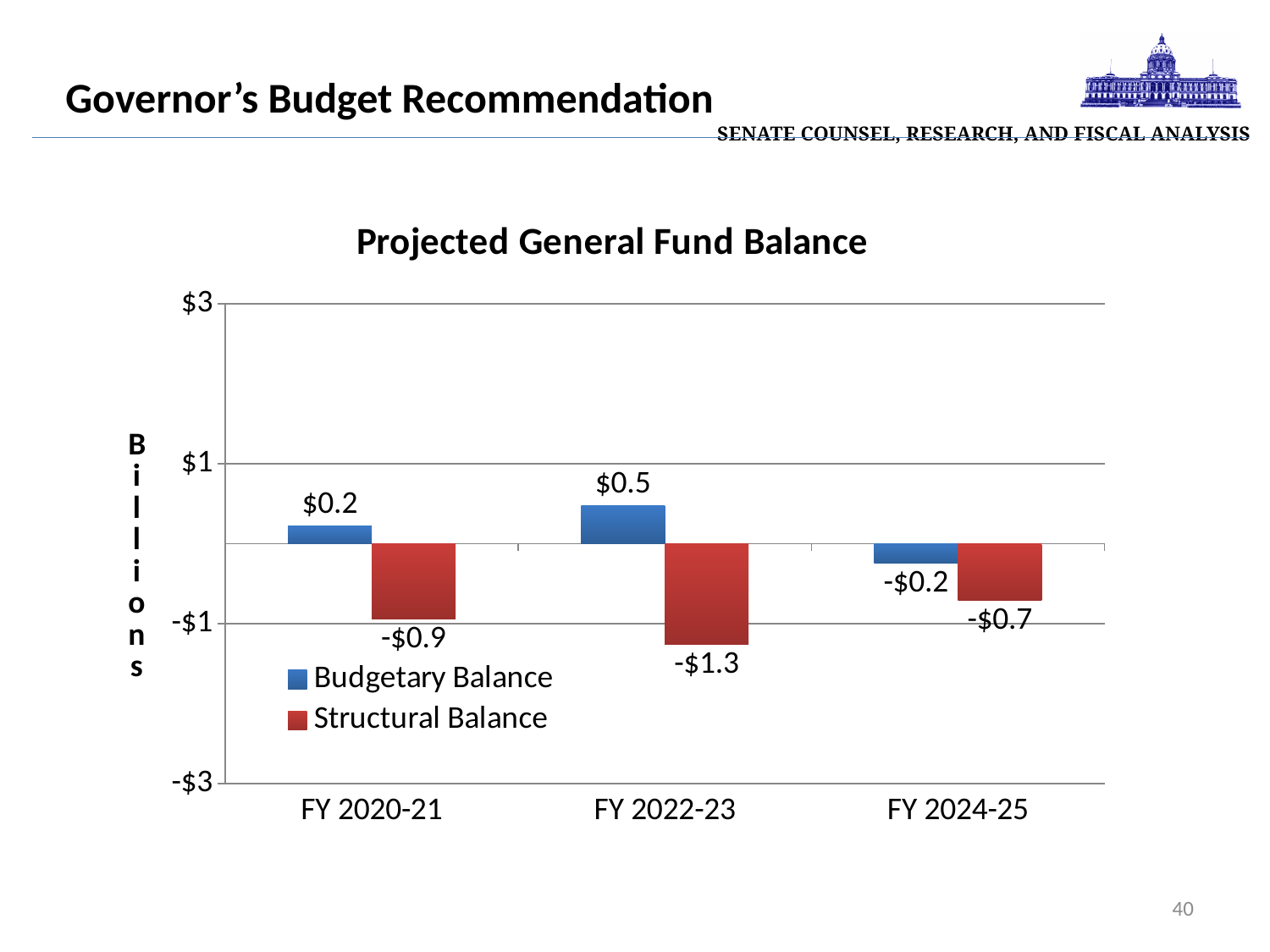
What is the Budgetary Balance for FY 2024-25? -$0.2 What is the Structural Balance for FY 2022-23? -$1.3 What is the Structural Balance for FY 2020-21? -$0.9 How many fiscal years are shown on the x axis? 3 Which fiscal year has the highest Budgetary Balance? FY 2022-23 What kind of chart is shown on the slide? Bar chart What is the Budgetary Balance for FY 2022-23? $0.5 Which is larger, the Structural Balance for FY 2020-21 or the Structural Balance for FY 2024-25? FY 2024-25 How many series does the legend list? 2 Which fiscal year has the lowest Structural Balance? FY 2022-23 What is the title of the chart? Projected General Fund Balance What is the difference between the Budgetary Balance and the Structural Balance for FY 2022-23? $1.8